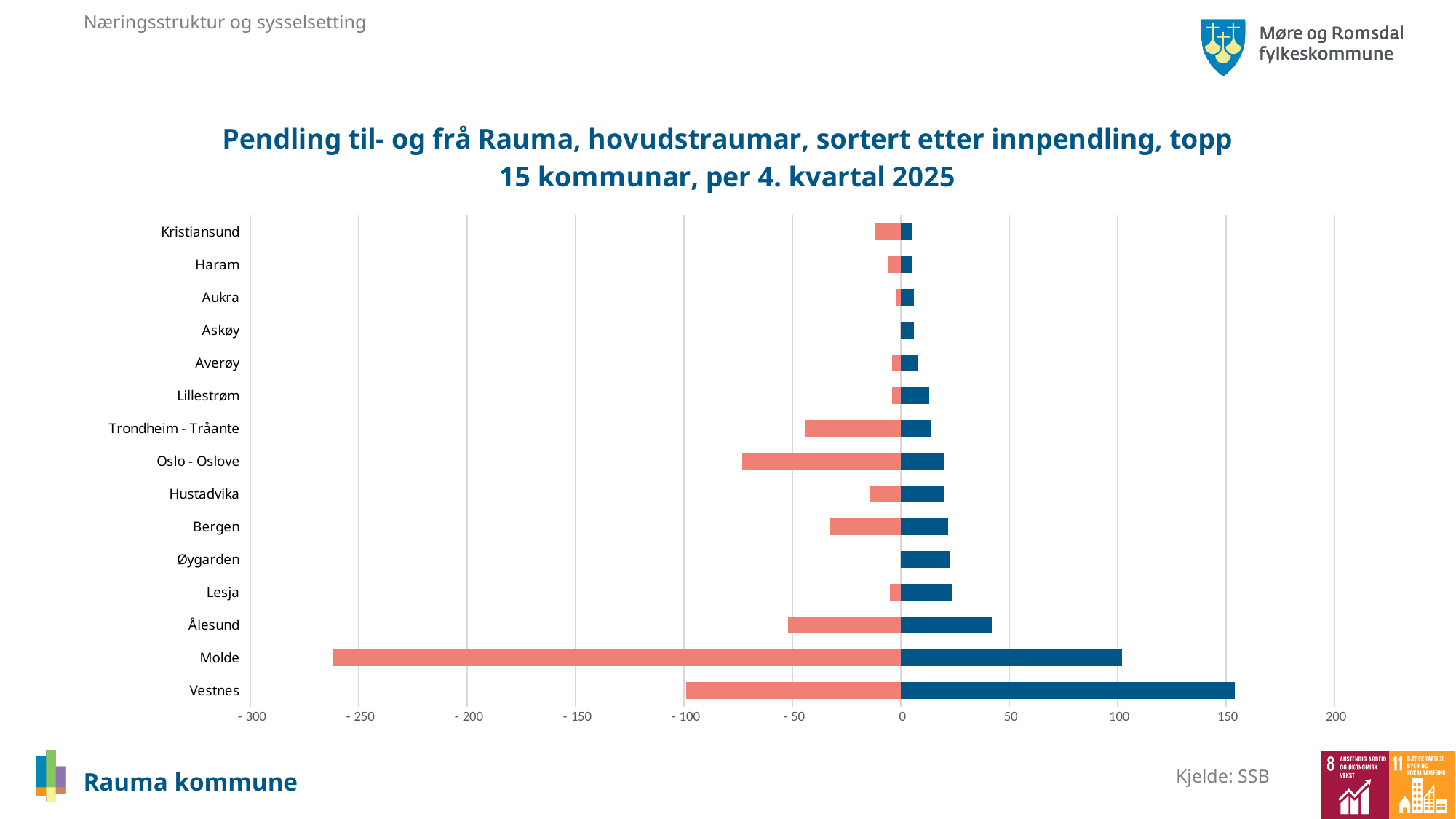
Which municipality has the longest red (negative) bar? Molde Is the blue bar for Ålesund greater or less than 50? less What kind of chart is shown on the slide? bar chart Is the blue bar for Vestnes greater or less than 100? greater What is the source cited for the chart? SSB Is the red bar for Oslo - Oslove greater or less than -50? less How many municipalities (categories) are listed on the chart? 15 Do the blue bars get longer or shorter going down the chart from Kristiansund to Vestnes? longer Which has the larger blue bar, Vestnes or Molde? Vestnes Which municipality has the longest blue (positive) bar? Vestnes Which has the larger blue bar, Ålesund or Lesja? Ålesund